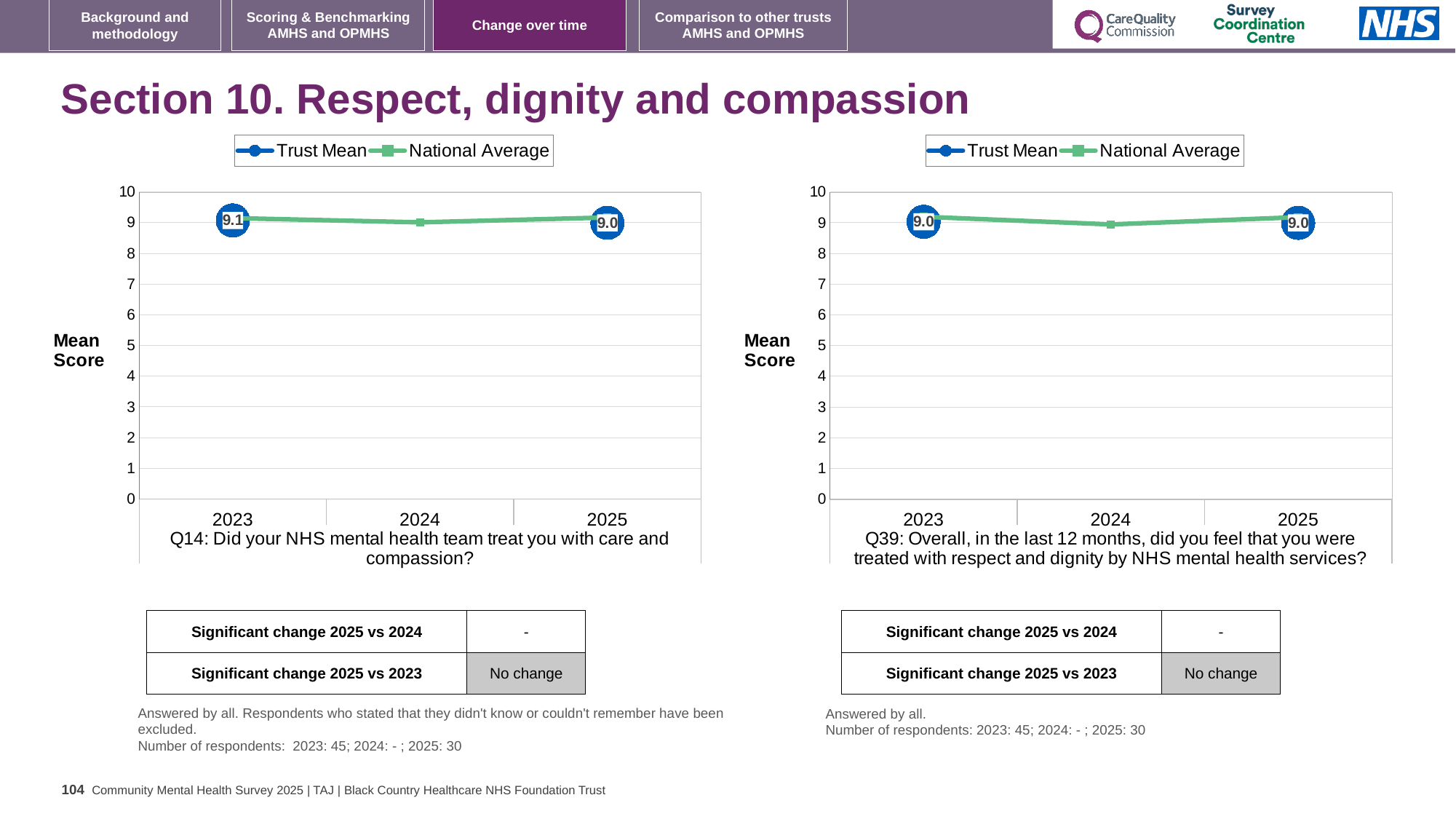
In the right chart (Q39), what is the Trust Mean score for 2023? 9.0 How many years are shown on the x axis of the left chart (Q14)? 3 What is the y-axis label of the right chart (Q39)? Mean Score In the right chart (Q39), what is the Trust Mean score for 2025? 9.0 How many series does the legend of the right chart (Q39) list? 2 In the left chart (Q14), what is the difference between the Trust Mean scores for 2023 and 2025? 0.1 In the right chart (Q39), is the National Average value for 2024 greater or less than 8? greater In the left chart (Q14), what is the Trust Mean score for 2025? 9.0 In the left chart (Q14), what is the Trust Mean score for 2023? 9.1 In the left chart (Q14), does the Trust Mean rise or fall from 2023 to 2025? fall In the left chart (Q14), which year has the higher Trust Mean score, 2023 or 2025? 2023 What kind of chart is the left chart (Q14)? line chart